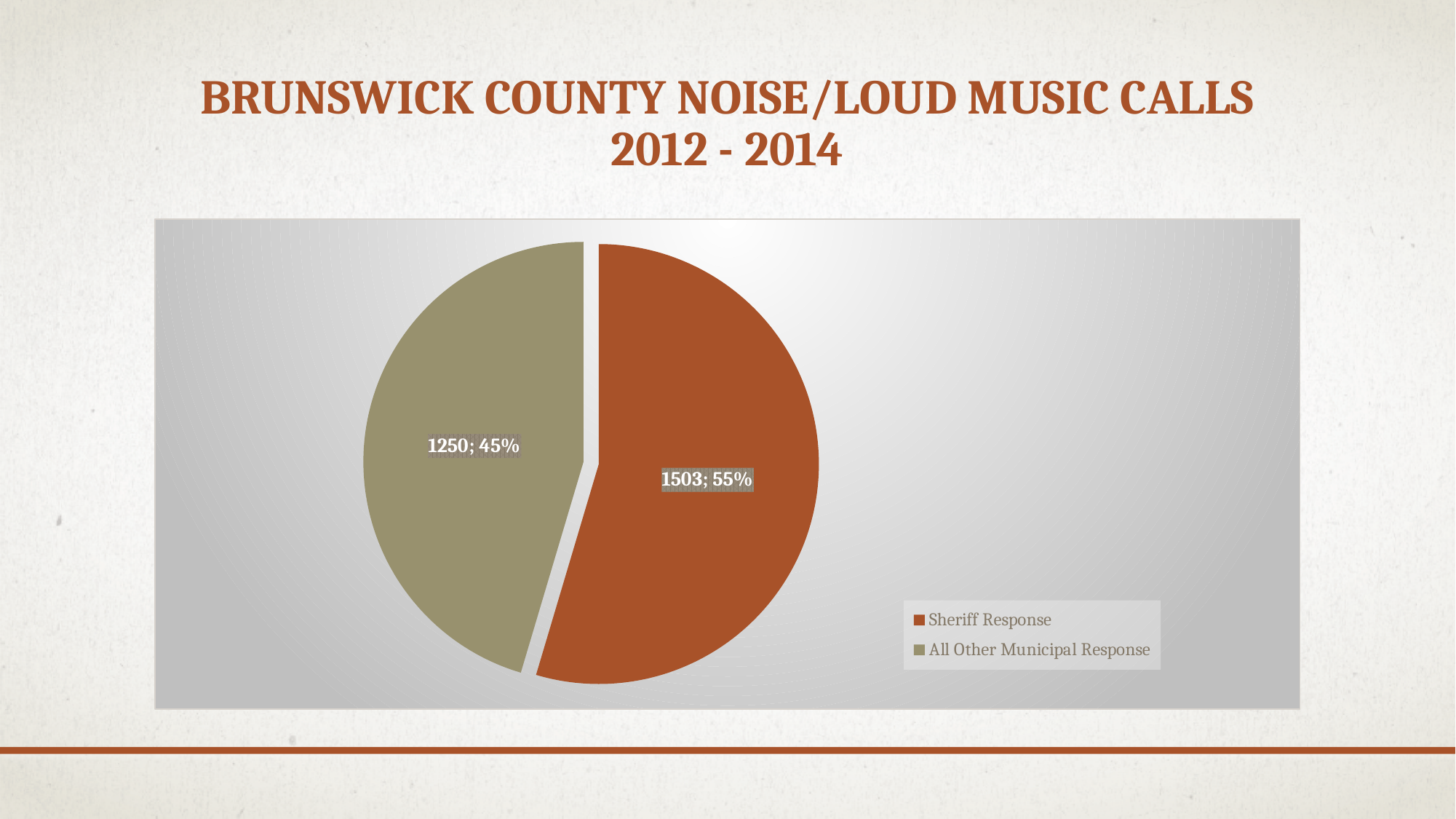
What share of the pie does Sheriff Response represent? 55% What is the total number of calls shown across both slices? 2753 Which is larger, Sheriff Response or All Other Municipal Response? Sheriff Response How many calls are attributed to All Other Municipal Response? 1250 Which category has the smallest slice of the pie? All Other Municipal Response What is the title of the slide containing the chart? Brunswick County Noise/Loud Music Calls 2012 - 2014 Which category has the largest slice of the pie? Sheriff Response What kind of chart is shown on the slide? Pie chart What share of the pie does All Other Municipal Response represent? 45% How many calls are attributed to Sheriff Response? 1503 What is the difference in calls between Sheriff Response and All Other Municipal Response? 253 How many slices does the pie chart have? 2